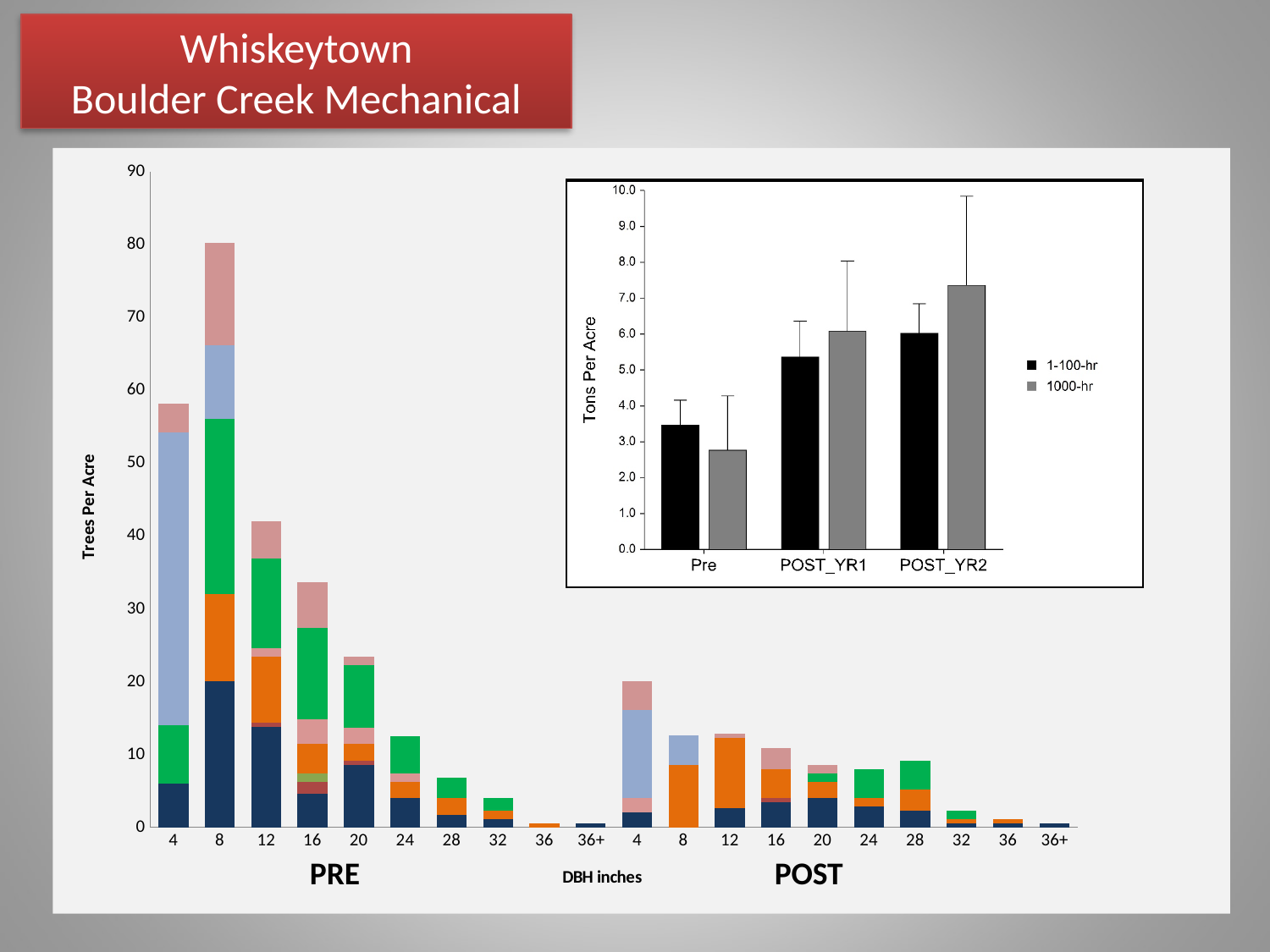
In the inset chart (Tons Per Acre), do the 1-100-hr values rise or fall from Pre to POST_YR2? rise In the inset chart (Tons Per Acre), which category has the tallest 1000-hr bar? POST_YR2 In the large chart (Trees Per Acre), is the total for the PRE 4 bar greater or less than 50? greater In the large chart (Trees Per Acre), which DBH bar is the tallest? PRE 8 In the large chart (Trees Per Acre), which is taller: the 4-inch bar in PRE or the 4-inch bar in POST? PRE In the inset chart (Tons Per Acre), how many series does the legend list? 2 In the inset chart (Tons Per Acre), is the 1000-hr value for POST_YR2 greater or less than 7.0? greater In the inset chart (Tons Per Acre), is the 1000-hr value for Pre greater or less than 3.0? less What kind of chart is the large chart on the slide? stacked bar chart In the large chart (Trees Per Acre), how many bars are plotted across the PRE and POST groups combined? 20 In the inset chart (Tons Per Acre), which bar is the lowest overall? 1000-hr at Pre